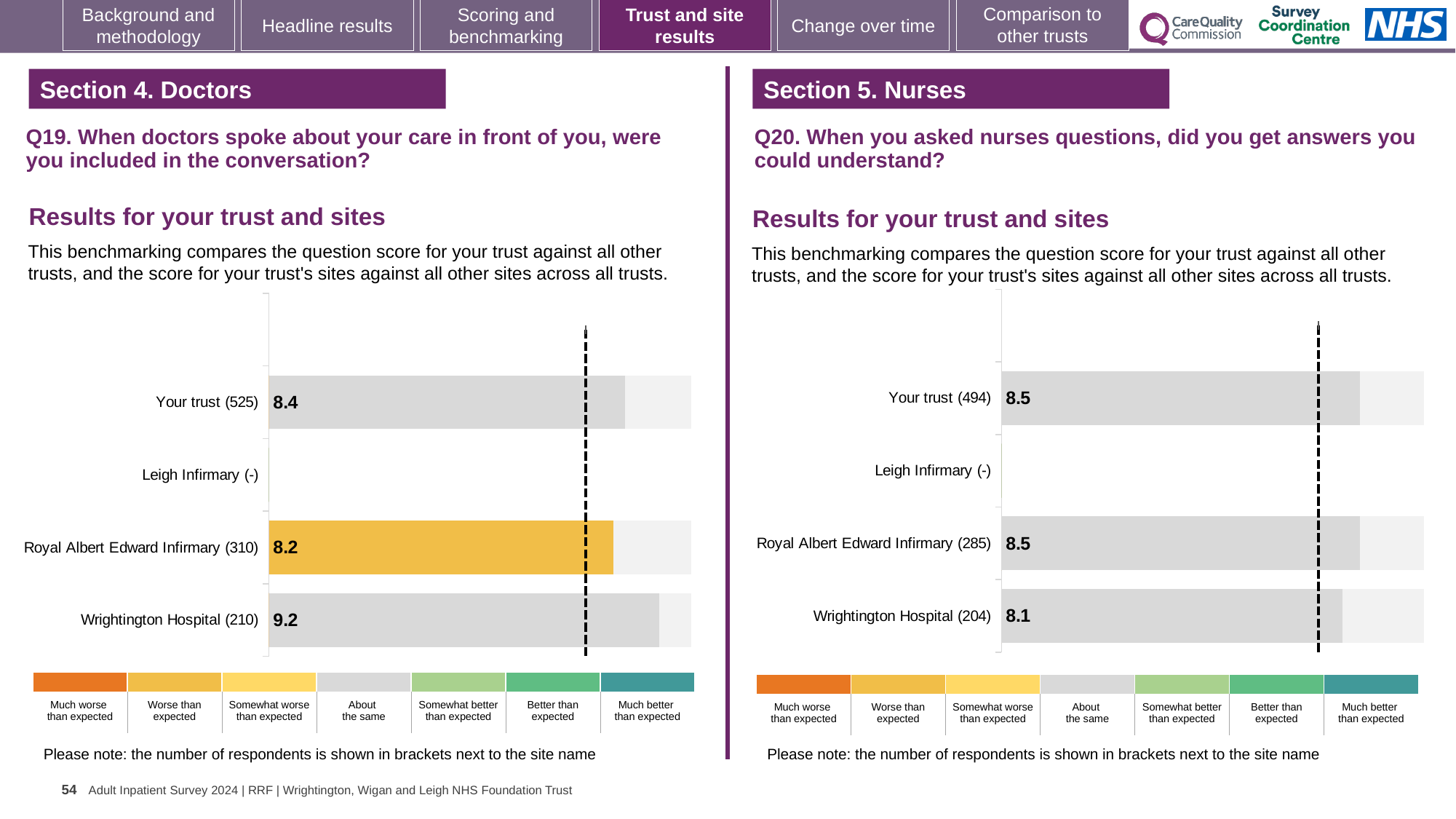
Which is larger: the Your trust score in the Q19 chart or the Your trust score in the Q20 chart? Q20 chart (8.5) In the Q20 chart (right), which site has the lowest score among those with a score shown? Wrightington Hospital In the Q20 chart (right), what is the score for Royal Albert Edward Infirmary? 8.5 In the Q19 chart (left), what is the score for Wrightington Hospital? 9.2 In the Q19 chart (left), which site has the highest score? Wrightington Hospital What type of chart is used in the Q20 chart (right)? Bar chart In the Q19 chart (left), which benchmark category does the colour of the Royal Albert Edward Infirmary bar indicate? Worse than expected In the Q20 chart (right), what is the score for Wrightington Hospital? 8.1 In the Q19 chart (left), what is the difference between the scores for Wrightington Hospital and Royal Albert Edward Infirmary? 1.0 In the Q19 chart (left), how many respondents are shown for Your trust? 525 In the Q20 chart (right), what is the difference between the scores for Your trust and Wrightington Hospital? 0.4 In the Q19 chart (left), what is the score for Your trust? 8.4